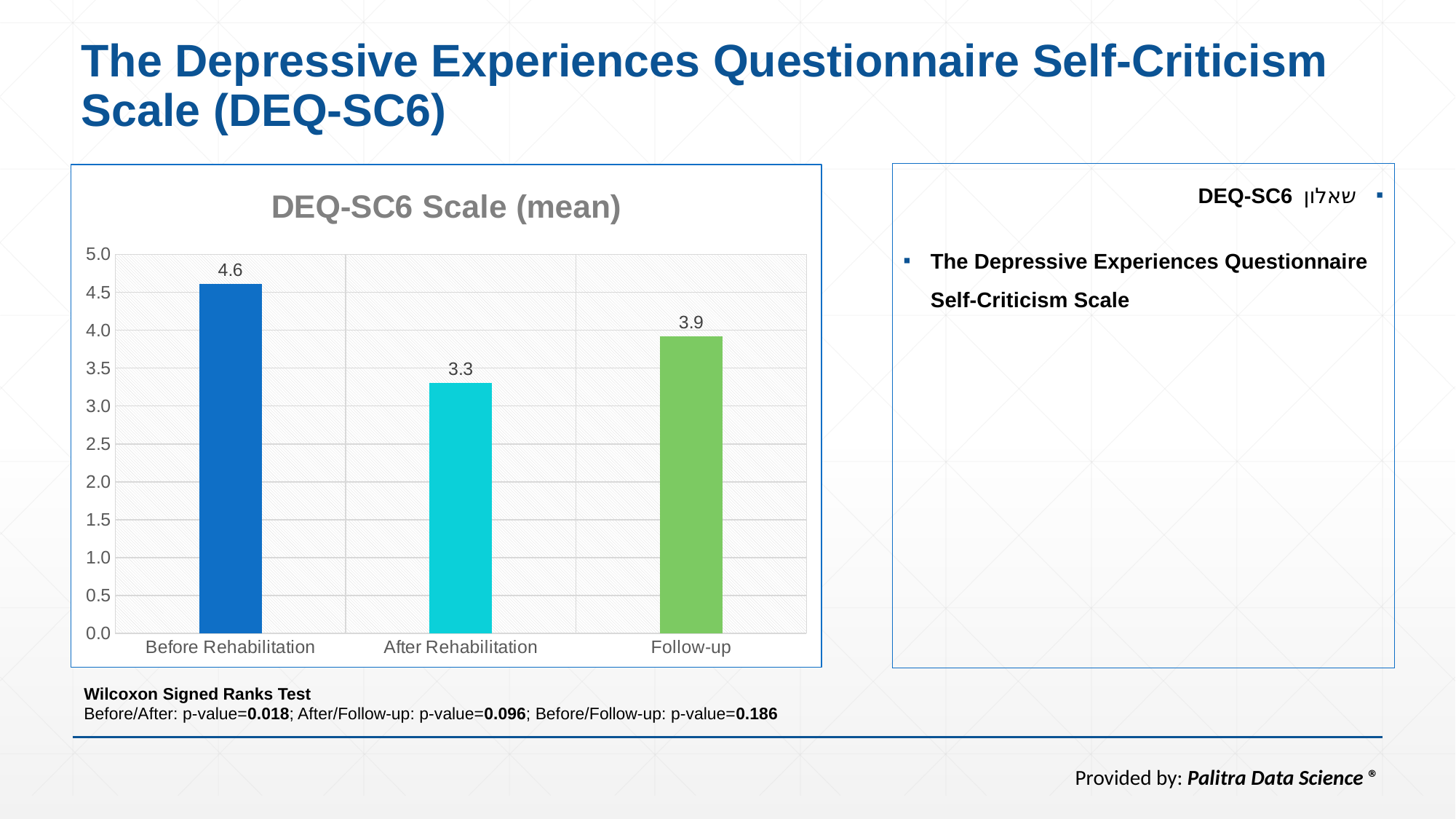
Which time point has the highest mean DEQ-SC6 value? Before Rehabilitation How many time points are shown in the chart? 3 Which is larger, the mean value at Follow-up or After Rehabilitation? Follow-up Which time point has the lowest mean DEQ-SC6 value? After Rehabilitation What is the difference between the Before Rehabilitation and After Rehabilitation mean values? 1.3 What kind of chart is shown on the slide? Bar chart What is the mean DEQ-SC6 value for Before Rehabilitation? 4.6 What is the title of the chart? DEQ-SC6 Scale (mean) What is the difference between the Follow-up and After Rehabilitation mean values? 0.6 Is the value for Before Rehabilitation greater or less than 4.0? greater What is the mean DEQ-SC6 value at Follow-up? 3.9 What is the mean DEQ-SC6 value for After Rehabilitation? 3.3